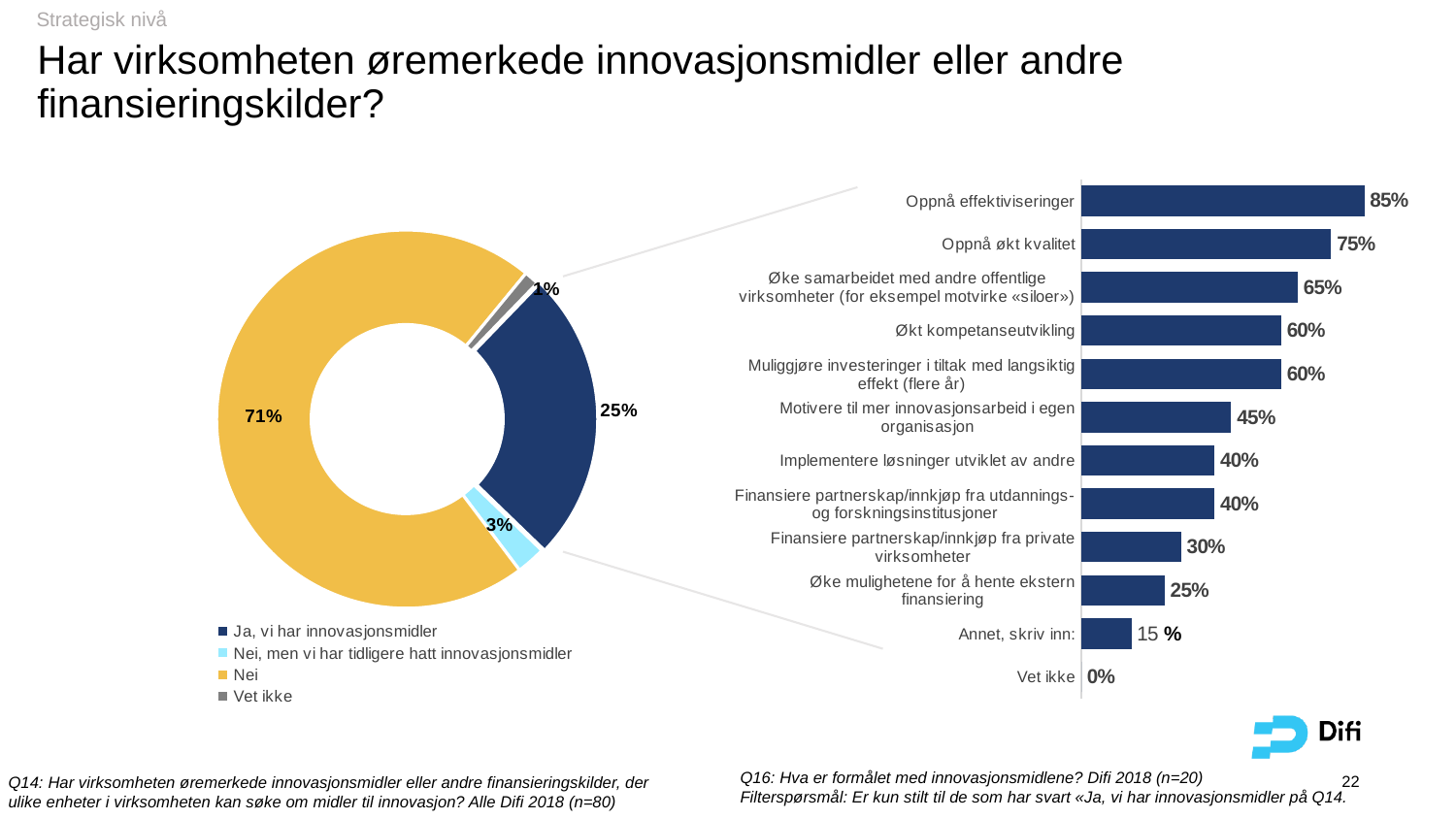
In the bar chart on the right, which category has the highest value? Oppnå effektiviseringer In the bar chart on the right, what is the value for "Finansiere partnerskap/innkjøp fra private virksomheter"? 30% In the bar chart on the right, what is the difference between "Oppnå effektiviseringer" and "Oppnå økt kvalitet"? 10 percentage points What kind of chart is shown on the left side of the slide? Donut (pie) chart In the donut chart on the left, what share of respondents answered "Ja, vi har innovasjonsmidler"? 25% In the bar chart on the right, what is the value for "Oppnå effektiviseringer"? 85% How many categories are shown in the bar chart on the right? 12 In the bar chart on the right, which is larger: "Økt kompetanseutvikling" or "Motivere til mer innovasjonsarbeid i egen organisasjon"? Økt kompetanseutvikling What kind of chart is shown on the right side of the slide? Bar chart In the donut chart on the left, which category has the smallest share? Vet ikke In the donut chart on the left, how many categories does the legend list? 4 In the donut chart on the left, what share of respondents answered "Nei"? 71%